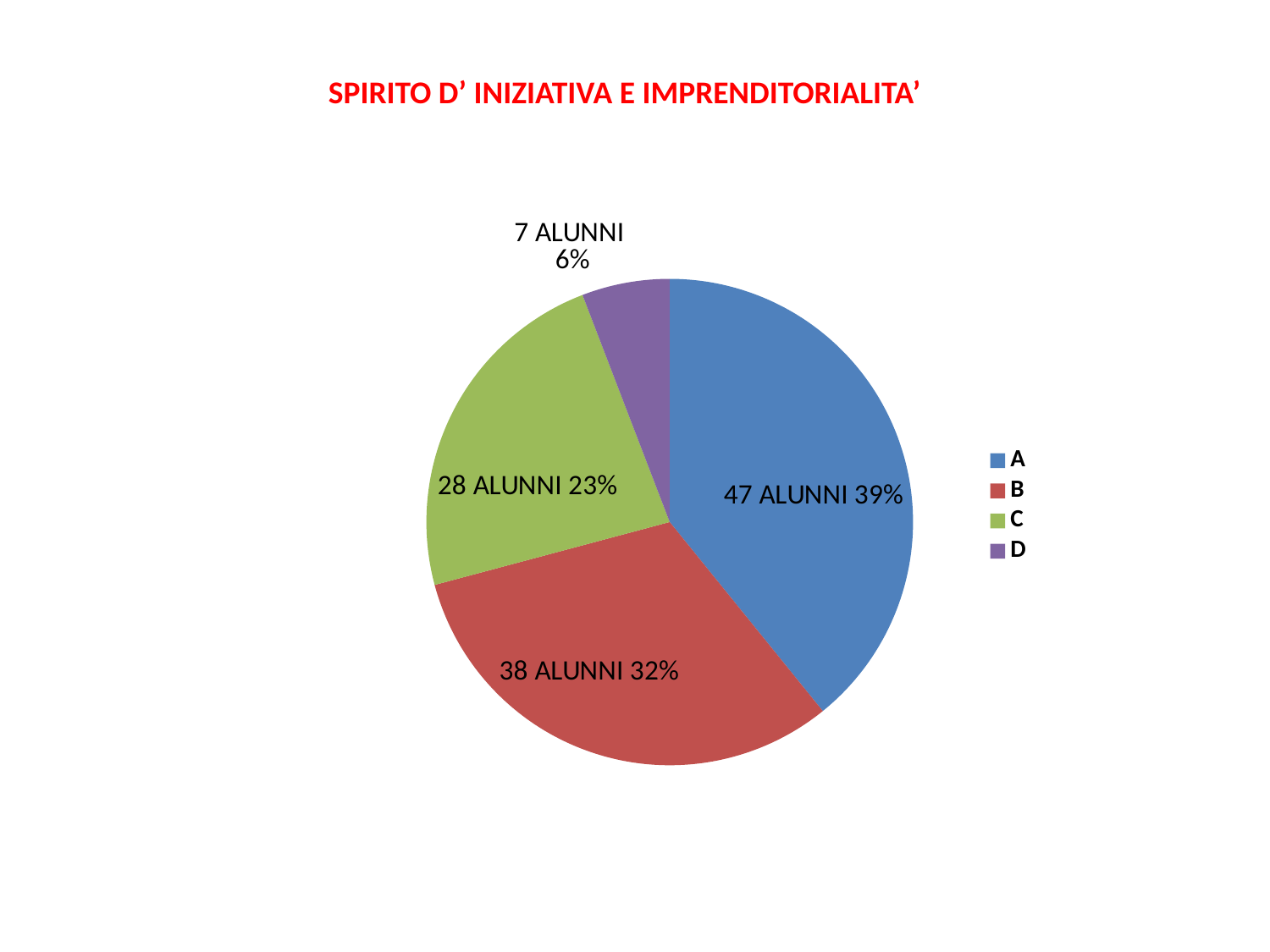
How many students (alunni) are in category A? 47 ALUNNI What percentage share does category B have? 32% What kind of chart is shown on the slide? pie chart How many students are in category C? 28 ALUNNI How many categories does the pie chart have? 4 What is the difference in number of students between category A and category B? 9 What percentage share does category D have? 6% Which category has the smallest slice? D Which category has the largest slice? A Which category has more students, B or C? B What is the title of the chart? SPIRITO D' INIZIATIVA E IMPRENDITORIALITA' What is the total number of students across all four categories? 120